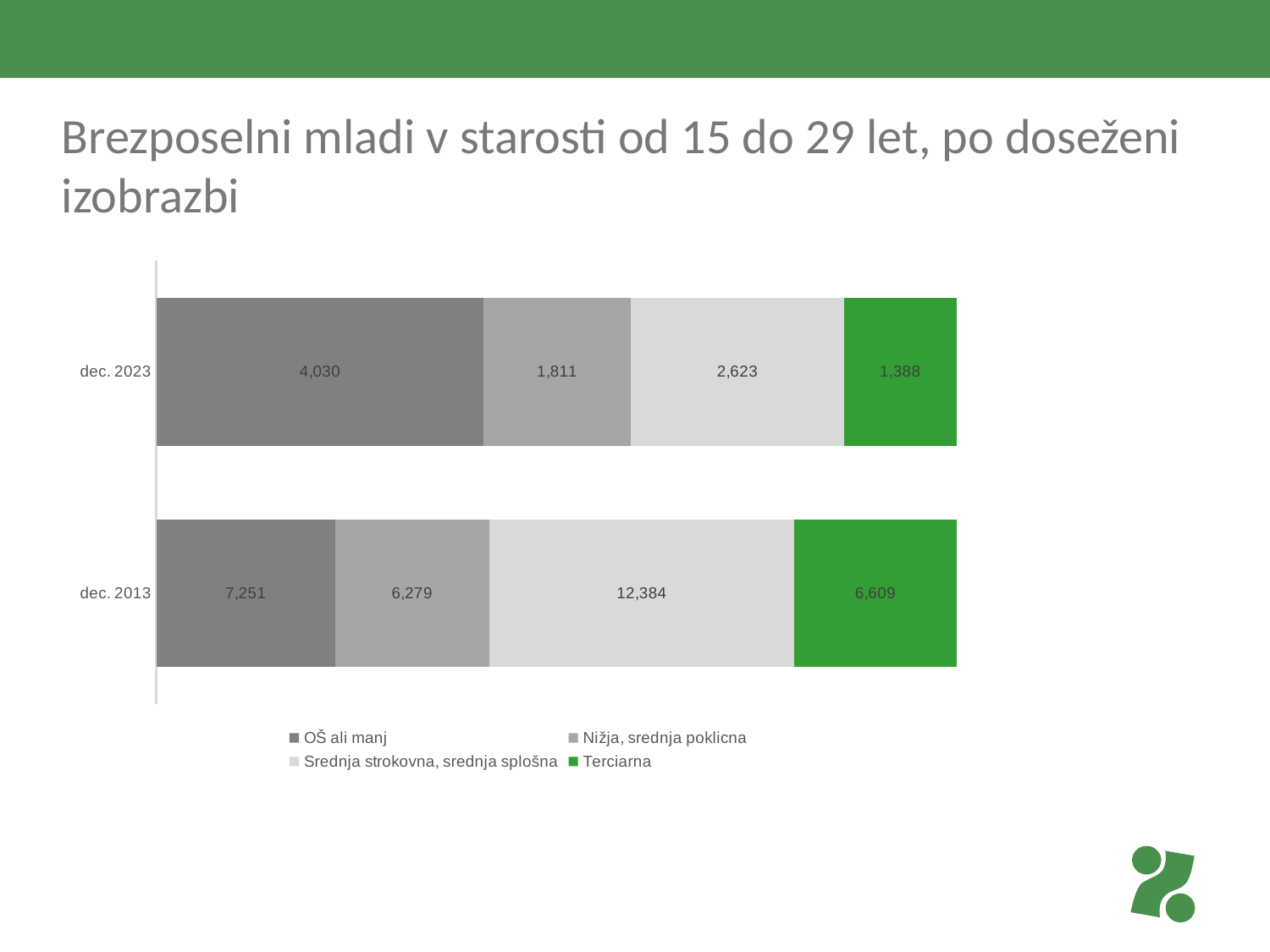
What is the value for 'Nižja, srednja poklicna' in dec. 2013? 6,279 Which is larger: 'Terciarna' in dec. 2013 or 'Srednja strokovna, srednja splošna' in dec. 2023? Terciarna in dec. 2013 What is the value for 'OŠ ali manj' in dec. 2023? 4,030 What is the value for 'Srednja strokovna, srednja splošna' in dec. 2013? 12,384 What is the value for 'Terciarna' in dec. 2023? 1,388 How many series does the legend list? 4 What is the total of all four segments for dec. 2023? 9,852 Which education group has the highest value in dec. 2013? Srednja strokovna, srednja splošna What is the difference between the 'OŠ ali manj' values in dec. 2013 and dec. 2023? 3,221 How many categories (time points) are shown on the chart? 2 Which education group has the lowest value in dec. 2023? Terciarna What kind of chart is shown on the slide? Stacked bar chart